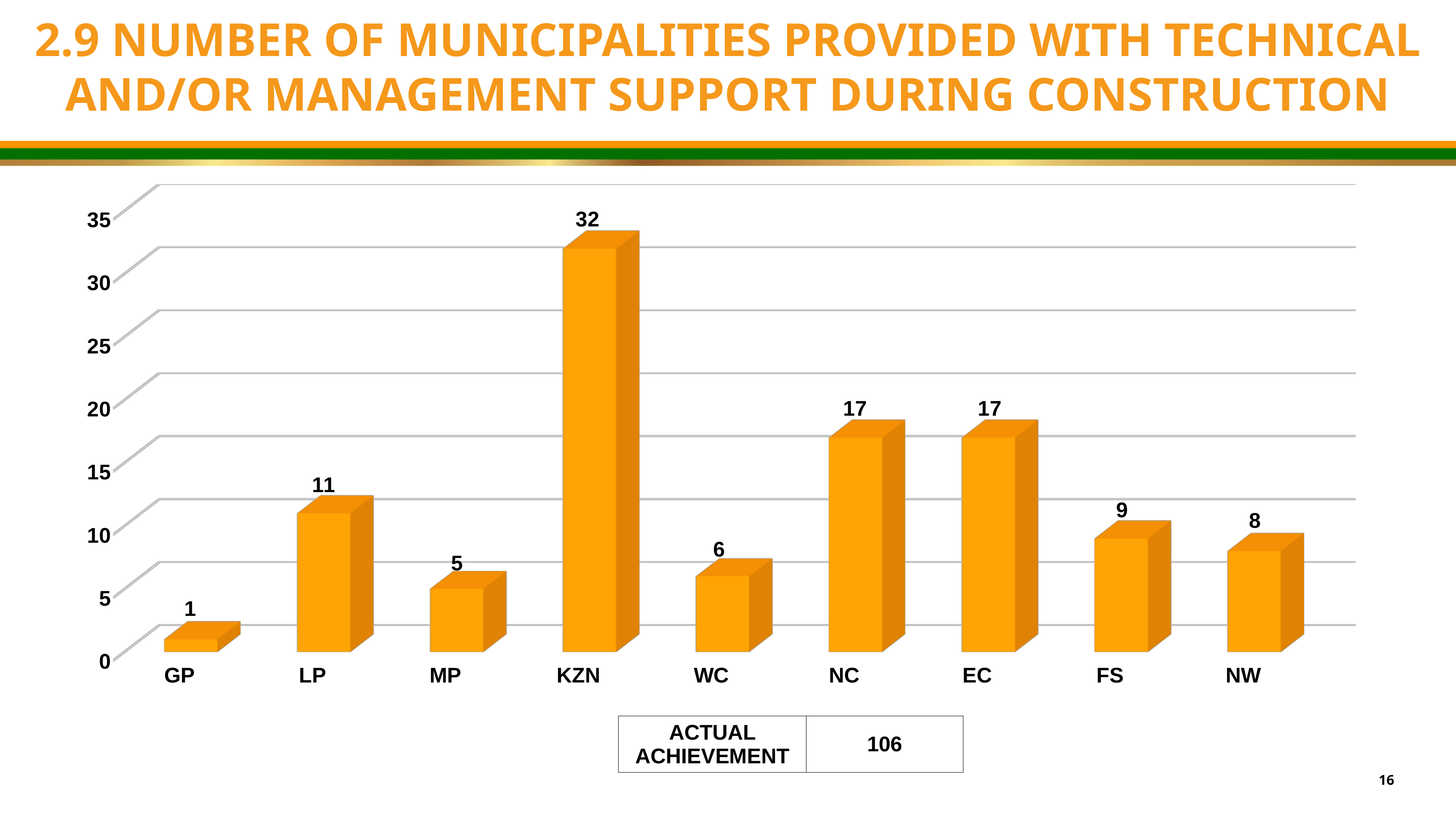
What is the value for FS? 9 What kind of chart is shown on the slide? Bar chart Which is larger, the value for WC or the value for NW? NW What is the difference between the values for LP and MP? 6 What is the difference between the values for KZN and NC? 15 Which province has the lowest value? GP What is the value for KZN? 32 What is the actual achievement total shown in the table below the chart? 106 What is the highest value labelled on the vertical axis? 35 Which province has the highest value? KZN What is the value for LP? 11 How many provinces are shown on the x axis? 9